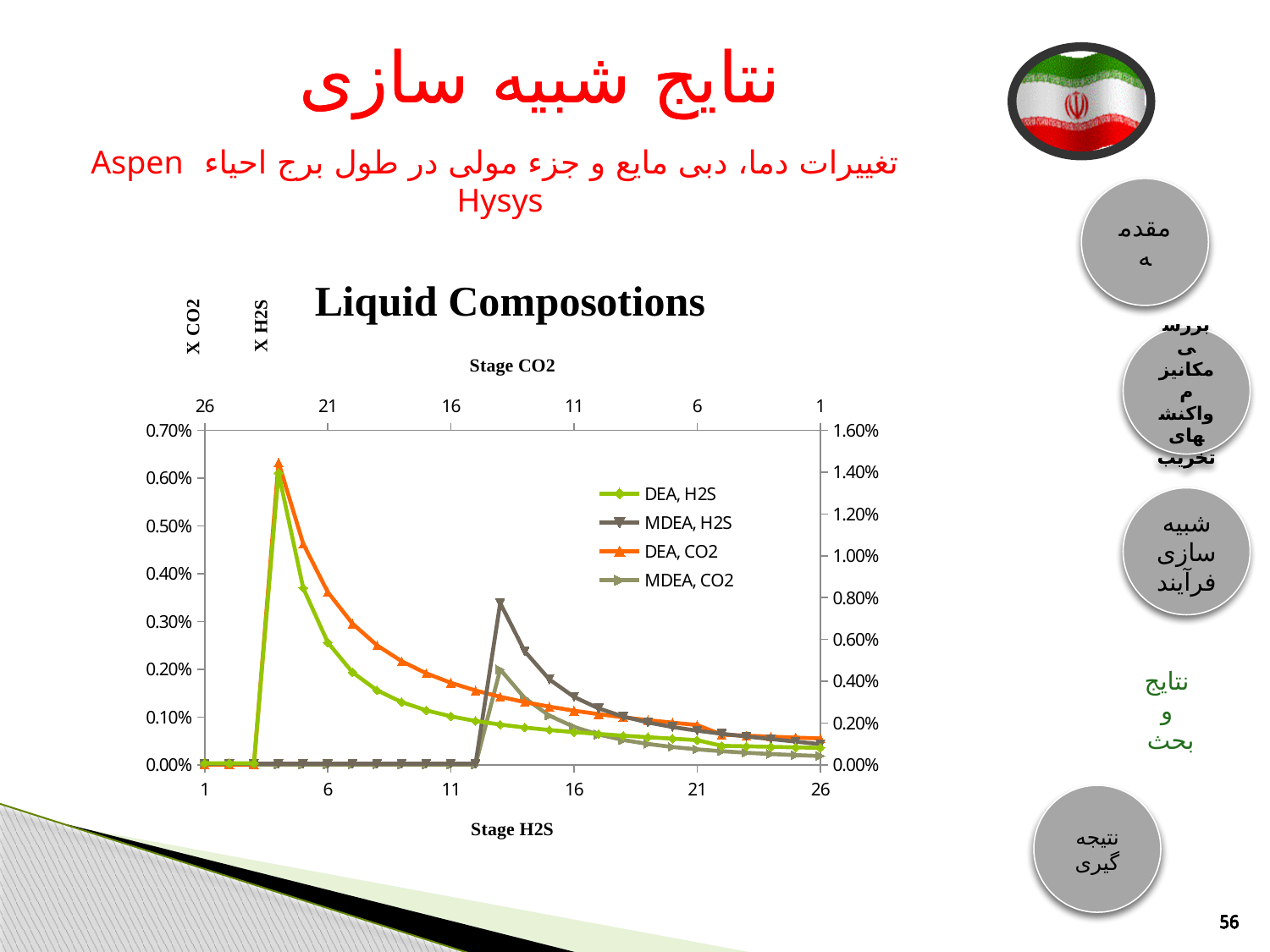
Which H2S series reaches its peak at a lower stage number, DEA, H2S or MDEA, H2S? DEA, H2S What is the title of the chart? Liquid Composotions What is the highest value shown on the left vertical axis of the chart? 0.70% After reaching its peak, does the DEA, H2S series rise or fall as the stage number increases toward 26? fall What is the highest value shown on the right vertical axis of the chart? 1.60% Is the peak value of the MDEA, H2S series greater or less than 0.40% on the left axis? less What type of chart is shown on the slide? line chart At stage 4 on the Stage H2S axis, which is larger: DEA, H2S or MDEA, H2S? DEA, H2S How many series does the legend of the chart list? 4 What is the largest stage number shown on the Stage H2S axis? 26 Is the peak value of the DEA, H2S series greater or less than 0.50% on the left axis? greater What is the label of the bottom horizontal axis of the chart? Stage H2S